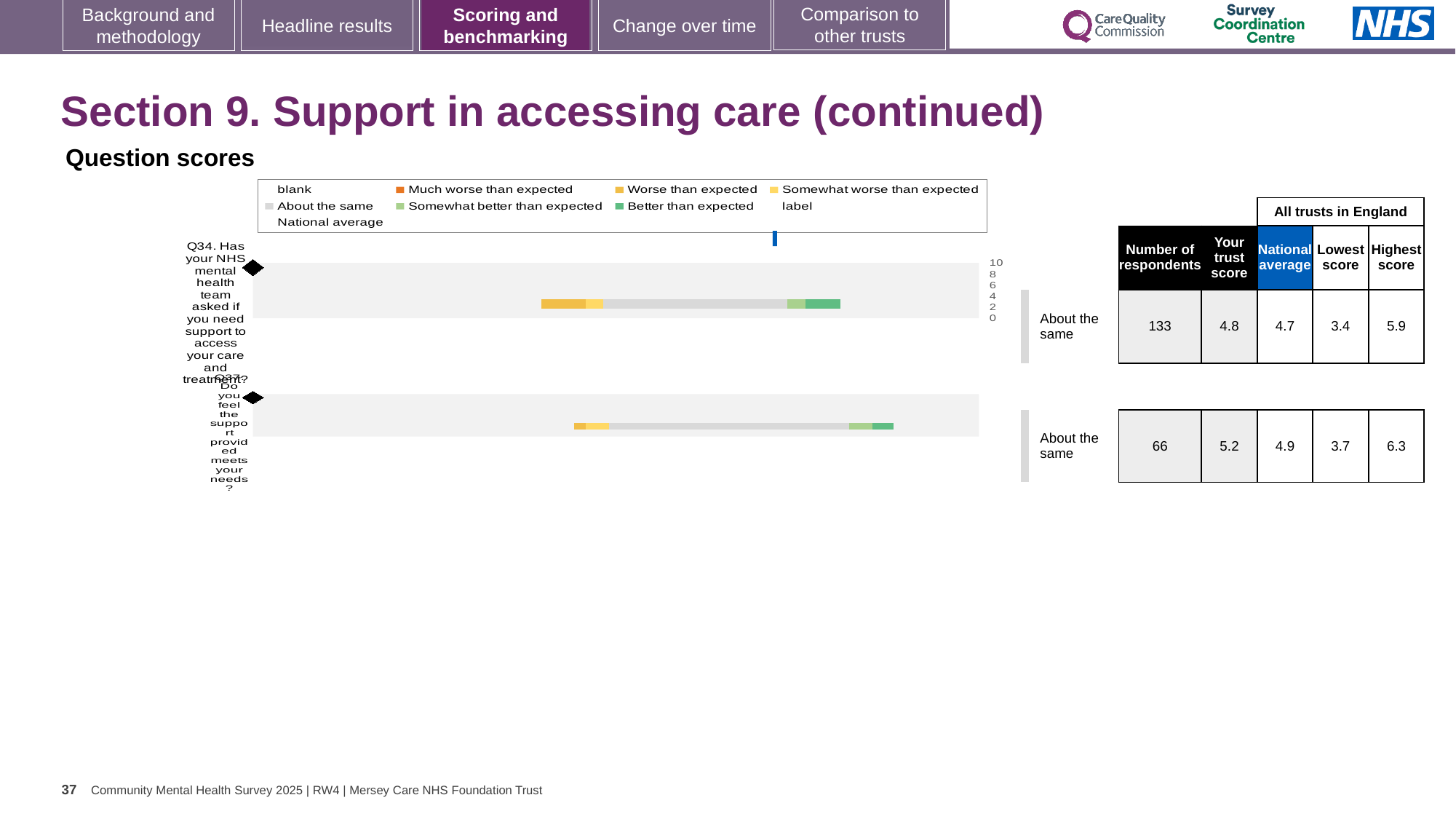
What kind of chart is shown under 'Question scores'? bar chart In the table beside the chart, what is 'Your trust score' for Q37? 5.2 Which question has the higher 'Your trust score' in the table, Q34 or Q37? Q37 In the table beside the chart, what is the national average for Q34? 4.7 What benchmark category is shown for Q34 next to the chart? About the same What is the maximum value shown on the chart's axis? 10 In the table beside the chart, how many respondents are listed for Q34? 133 In the chart legend, what colour represents 'Better than expected'? green By how much does the trust score for Q37 exceed the national average for Q37 in the table? 0.3 In the table beside the chart, what is the lowest score across all trusts in England for Q34? 3.4 In the table beside the chart, what is the highest score across all trusts in England for Q37? 6.3 How many questions (bars) are plotted in the 'Question scores' chart? 2